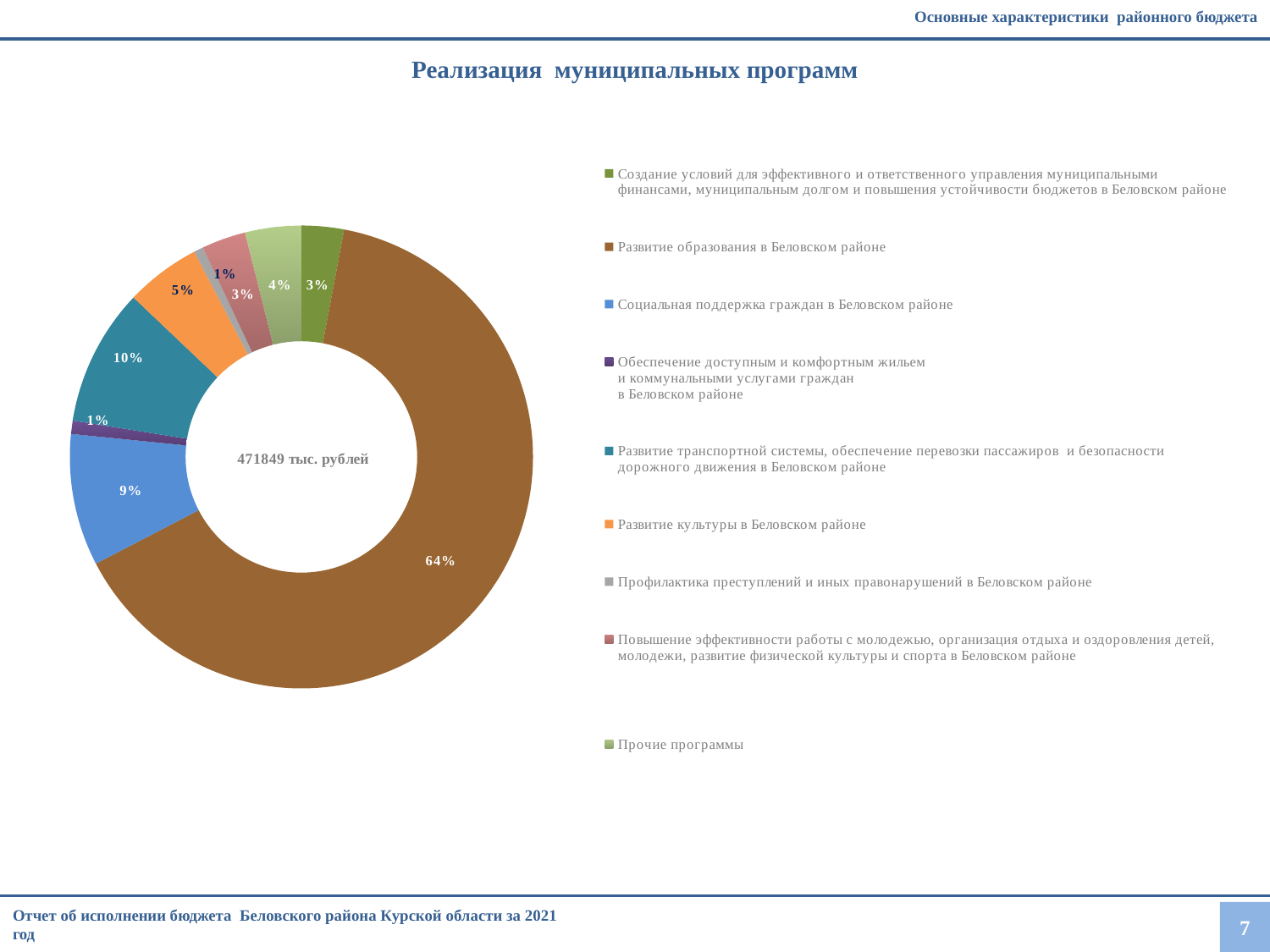
What kind of chart is shown on the slide? Pie chart (donut) What total amount is printed in the centre of the donut chart? 471849 тыс. рублей What share is shown for 'Социальная поддержка граждан в Беловском районе'? 9% What share of the chart does 'Развитие образования в Беловском районе' take? 64% What is the difference in percentage points between 'Развитие образования в Беловском районе' and 'Развитие транспортной системы, обеспечение перевозки пассажиров и безопасности дорожного движения в Беловском районе'? 54 percentage points How many entries does the legend list? 9 Which program has the largest share of the chart? Развитие образования в Беловском районе What share is shown for 'Развитие транспортной системы, обеспечение перевозки пассажиров и безопасности дорожного движения в Беловском районе'? 10% What is the smallest percentage shown on the chart? 1% What is the title of the chart on the slide? Реализация муниципальных программ